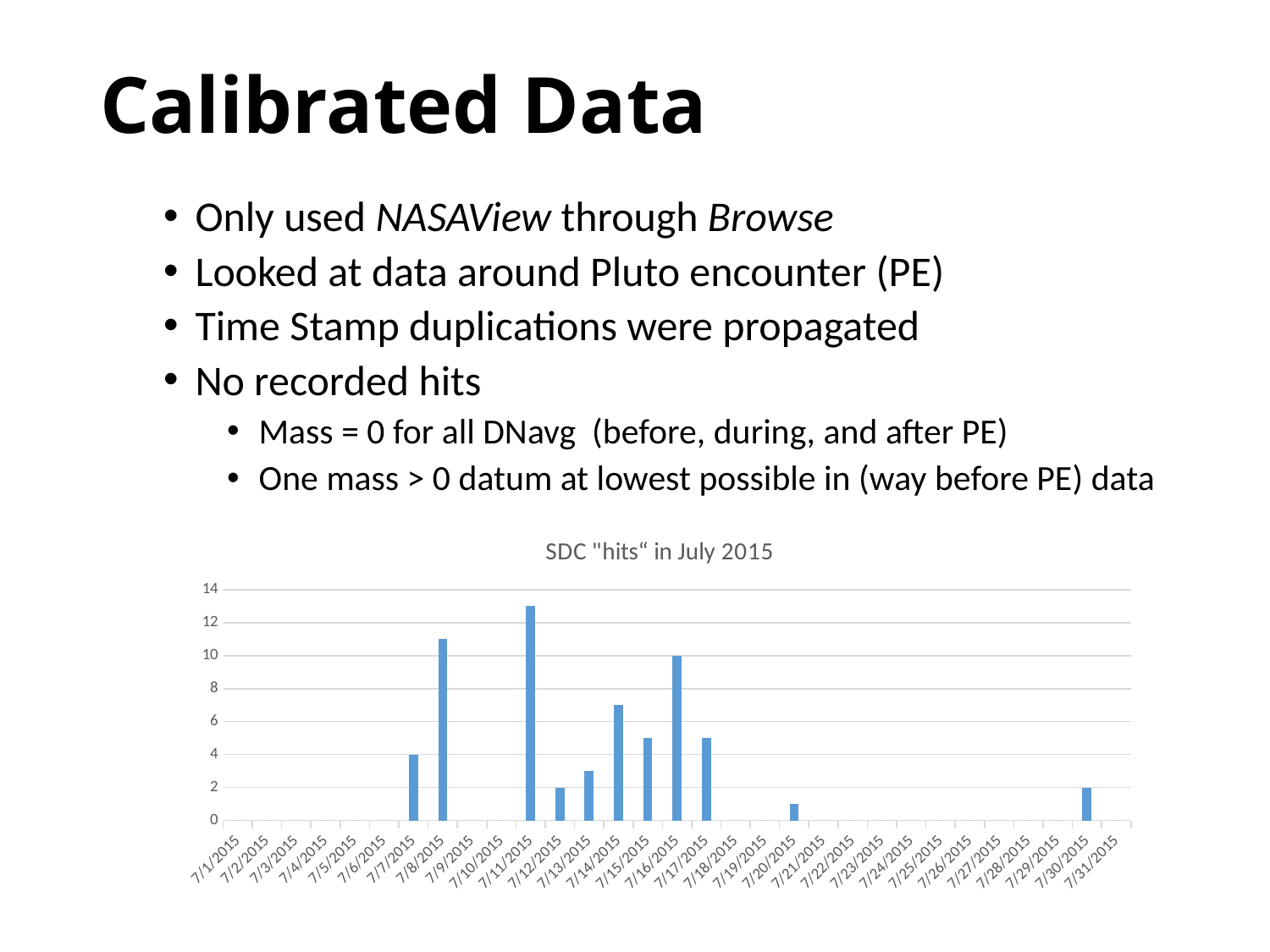
What is the title of the chart? SDC "hits" in July 2015 Is the value for 7/14/2015 greater or less than 8? less Which has more SDC hits, 7/8/2015 or 7/11/2015? 7/11/2015 Is the value for 7/20/2015 greater or less than 2? less How many SDC hits are shown for 7/7/2015? 4 Is the value for 7/11/2015 greater or less than 12? greater How many SDC hits are shown for 7/30/2015? 2 What kind of chart is shown on the slide? bar chart What is the difference between the SDC hits on 7/16/2015 and 7/7/2015? 6 Which date has the highest number of SDC hits? 7/11/2015 How many SDC hits are shown for 7/16/2015? 10 How many dates are shown on the x axis of the chart? 31